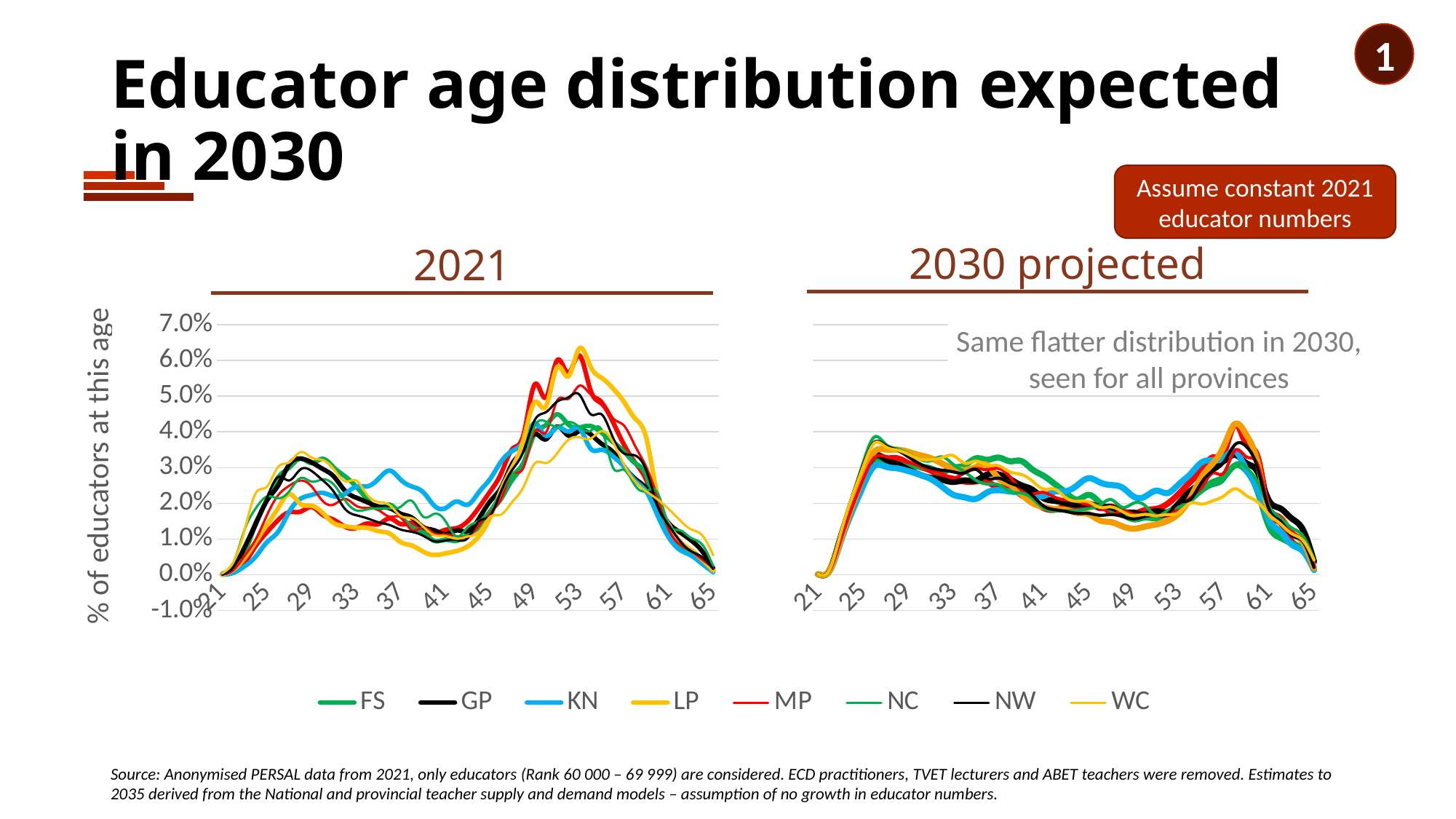
In the 2030 projected chart, is the peak value of the WC line around age 57 greater or less than 3.0%? less In the 2030 projected chart, do the lines rise or fall between age 21 and age 25? rise What is the label on the vertical axis of the charts? % of educators at this age How many series does the legend list? 8 What kind of chart is the 2021 chart on the left? line chart What is the title of the chart on the right? 2030 projected In the 2021 chart, do the lines rise or fall between age 57 and age 65? fall In the 2021 chart, is the value for KN at age 37 greater or less than 2.0%? greater How many age labels are shown on the x axis of the 2021 chart? 12 In the 2021 chart, is the value for LP at age 41 greater or less than 1.0%? less